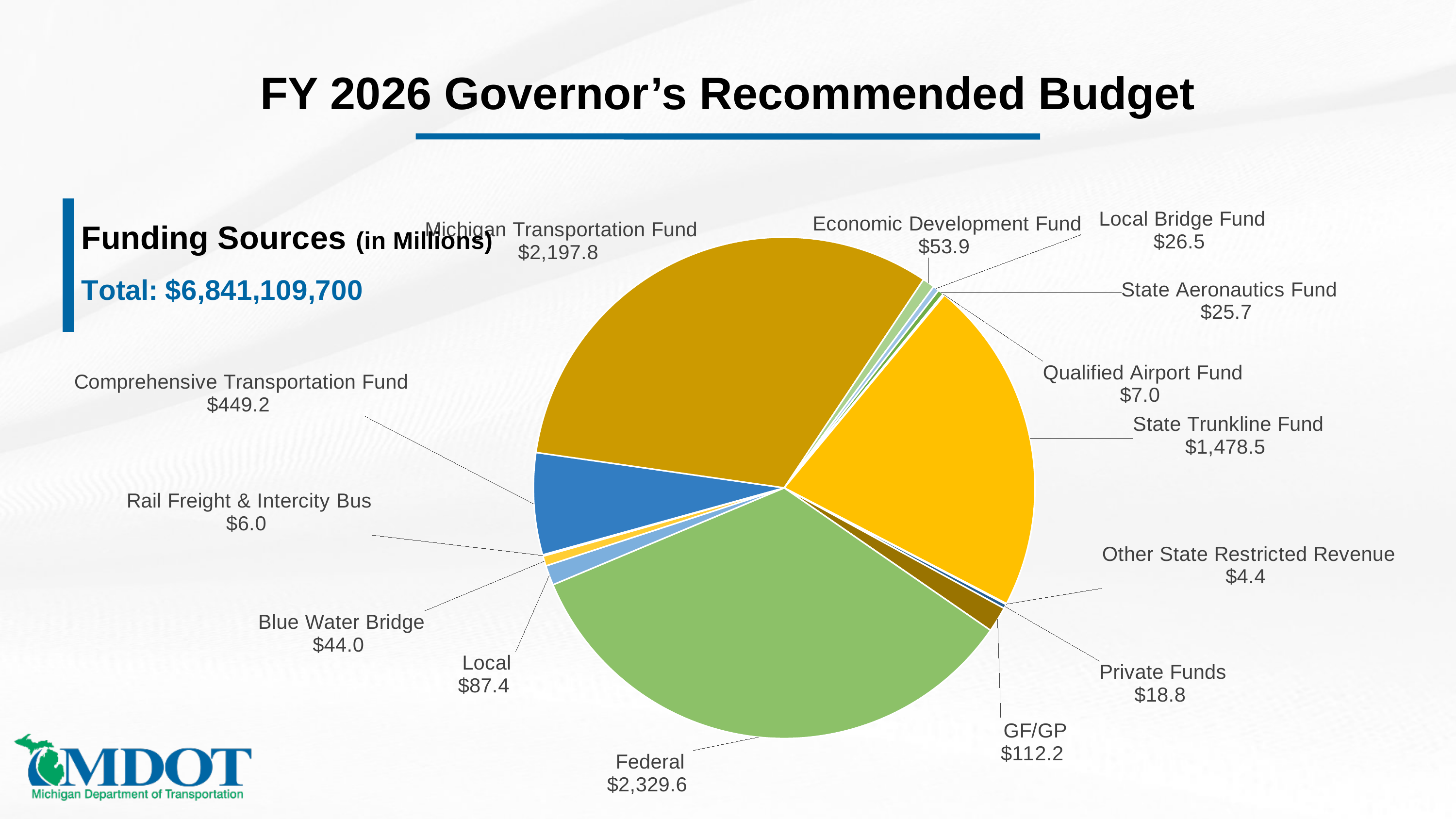
What is the value for the Comprehensive Transportation Fund? $449.2 How many funding sources are shown in the pie chart? 14 What type of chart is shown on the slide? Pie chart What is the value for GF/GP? $112.2 Which funding source is the largest slice of the pie? Federal What total is stated for the Funding Sources? $6,841,109,700 What is the difference between the State Trunkline Fund and the Comprehensive Transportation Fund? $1,029.3 What is the difference between the Federal value and the Michigan Transportation Fund value? $131.8 What is the value for the State Trunkline Fund? $1,478.5 Which is larger, Local or Blue Water Bridge? Local Which funding source has the smallest value? Other State Restricted Revenue What is the value for Federal in the Funding Sources pie chart? $2,329.6